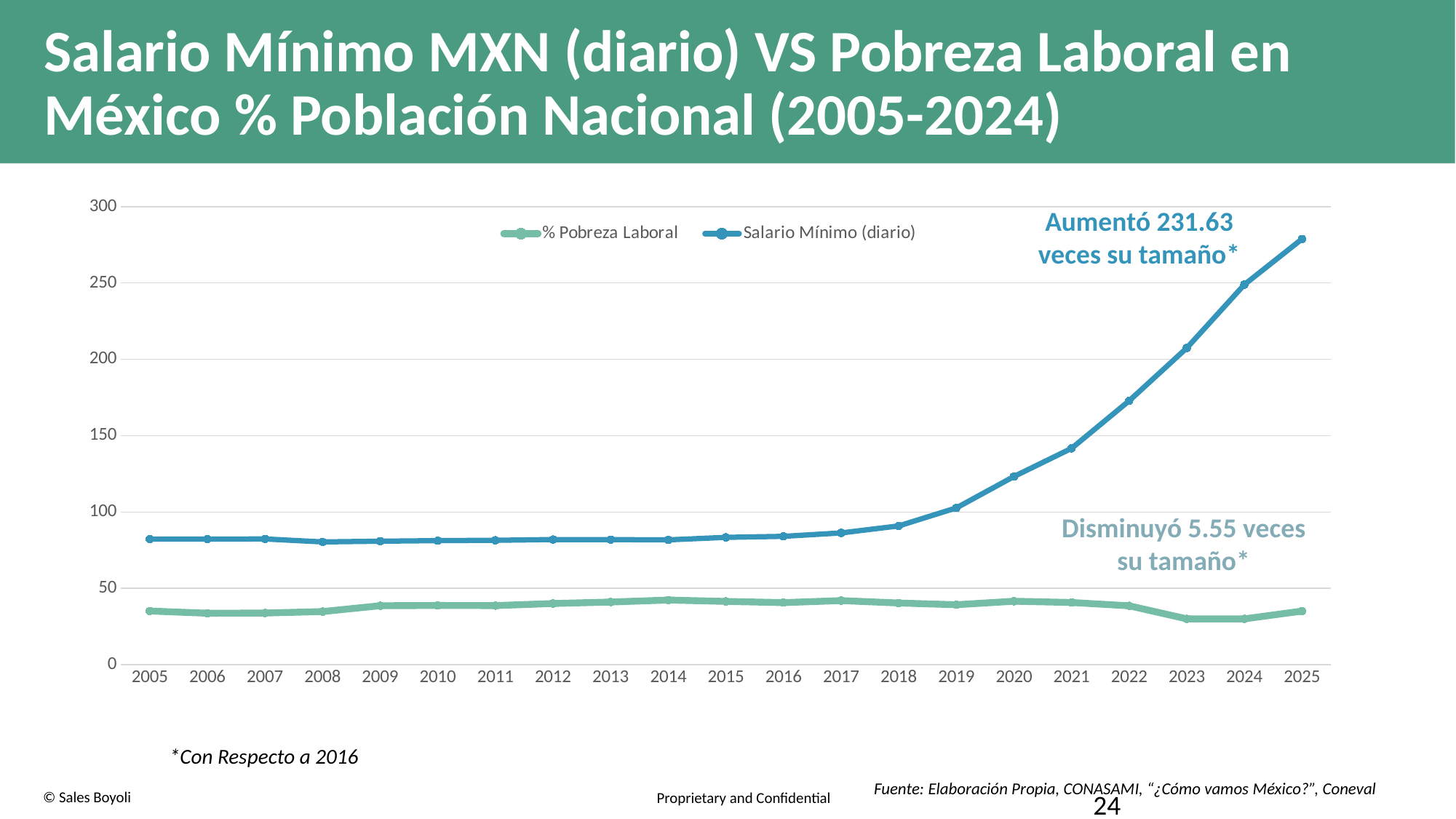
Which series has the larger value in 2020, % Pobreza Laboral or Salario Mínimo (diario)? Salario Mínimo (diario) How many series does the legend list? 2 Does the Salario Mínimo (diario) series rise or fall from 2018 to 2025? Rise Is the Salario Mínimo (diario) value for 2025 greater or less than 250? greater According to the annotation on the chart, by how many times did the Salario Mínimo increase in size? 231.63 veces Is the Salario Mínimo (diario) value for 2005 greater or less than 100? less Is the Salario Mínimo (diario) value for 2022 greater or less than 150? greater What kind of chart is shown on the slide? Line chart In which year is the Salario Mínimo (diario) value highest? 2025 How many years are plotted along the x axis? 21 Which is larger for Salario Mínimo (diario): the value in 2005 or the value in 2025? 2025